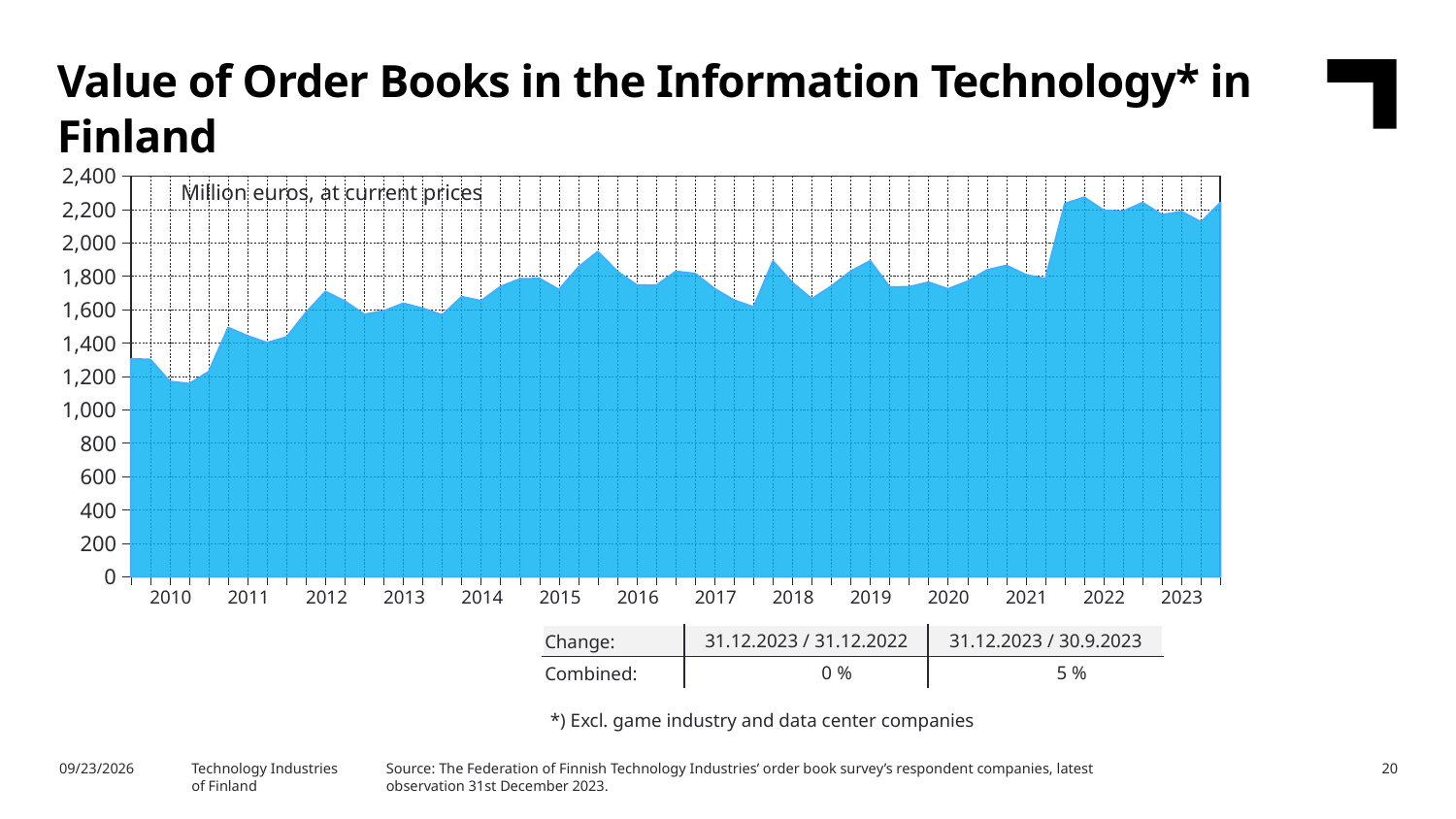
Is the value of order books at the start of 2010 greater or less than 1,400? less Is the value of order books in 2022 greater or less than 2,000? greater Which industries does the footnote say are excluded from the Information Technology figures? Game industry and data center companies What kind of chart is shown on the slide? Area chart What is the combined change in order books for 31.12.2023 compared with 30.9.2023? 5 % Overall, do the order book values rise or fall from 2010 to 2023? rise Is the value of order books in 2016 greater or less than 1,600? greater How many years are labelled on the x axis of the chart? 14 In which year does the value of order books reach its lowest level? 2010 Is the value of order books higher in 2022 or in 2010? 2022 In what unit are the order book values measured, according to the label inside the chart? Million euros, at current prices